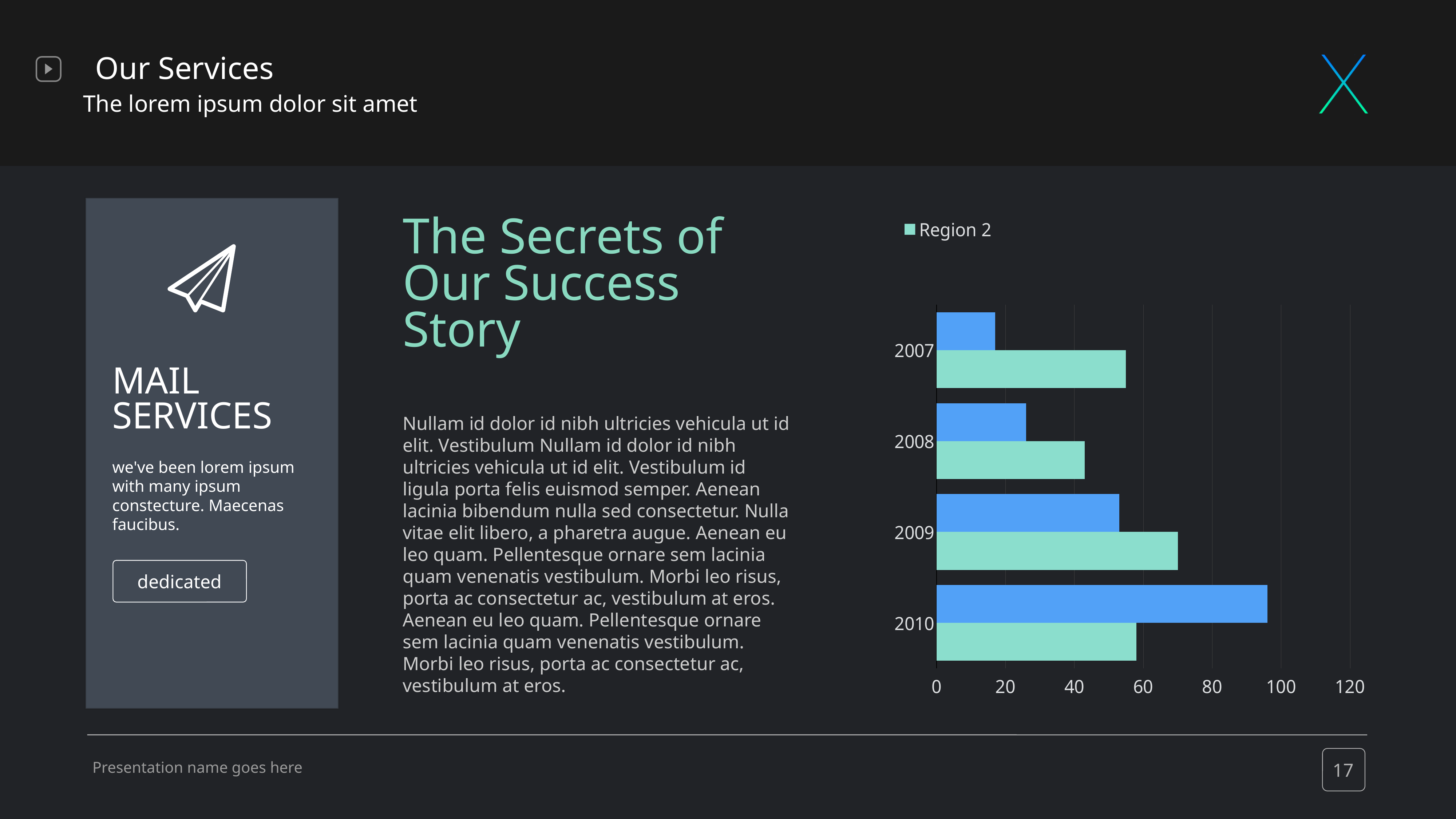
Is the Region 2 value for 2009 greater or less than 60? greater Is the Region 2 value for 2008 greater or less than 60? less What is the name of the series listed in the chart legend? Region 2 How many series does the chart legend list? 1 What kind of chart is shown on the slide? bar chart For Region 2, which year has the larger value, 2008 or 2009? 2009 Is the Region 2 value for 2007 greater or less than 40? greater Which year has the highest value for Region 2? 2009 How many year categories does the chart show? 4 Which year has the lowest value for Region 2? 2008 What is the highest value shown on the chart's horizontal axis? 120